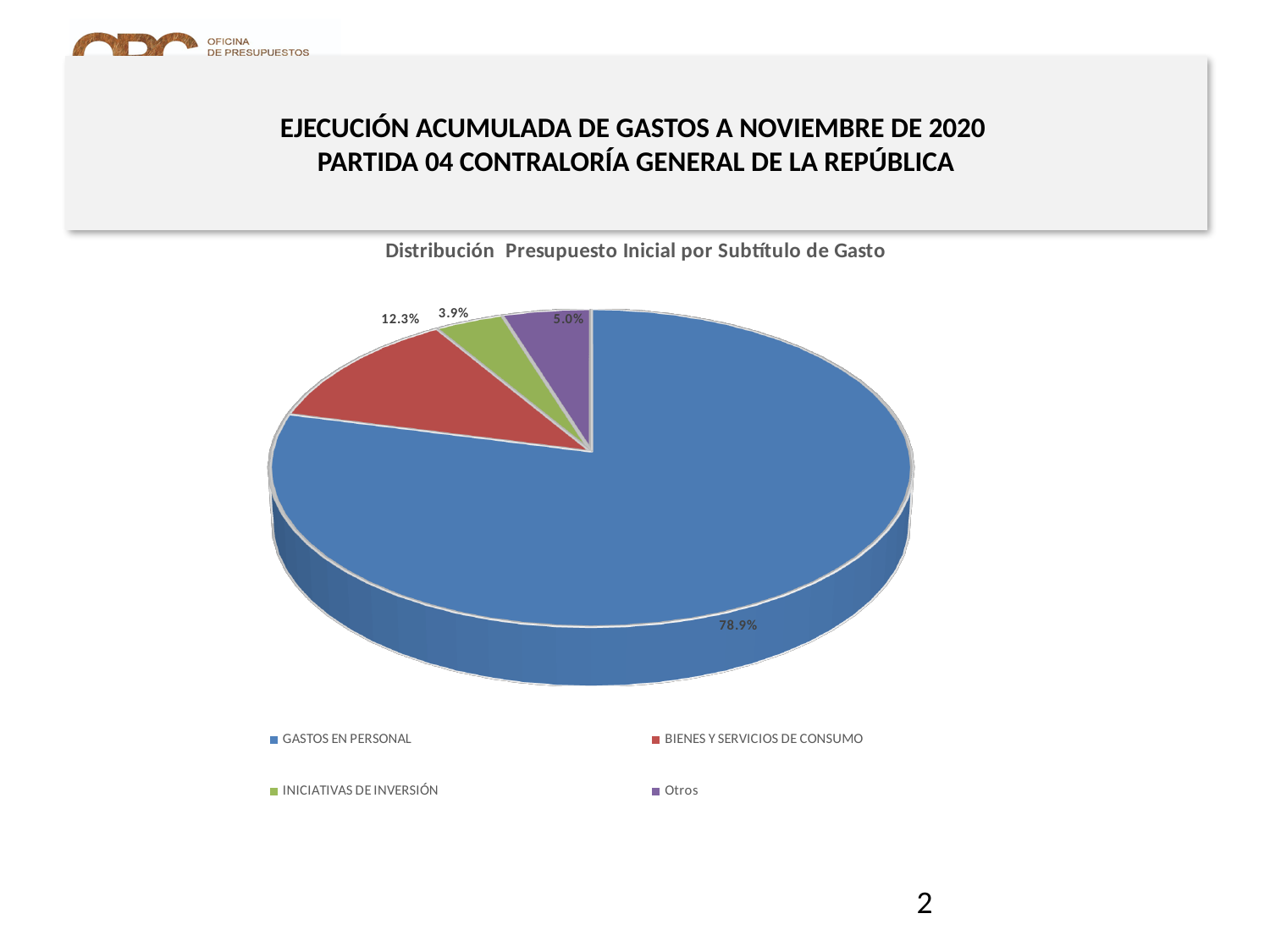
What share of the pie does INICIATIVAS DE INVERSIÓN represent? 3.9% Which category has the largest slice of the pie? GASTOS EN PERSONAL What share of the pie does GASTOS EN PERSONAL represent? 78.9% Which is larger, the share for Otros or the share for INICIATIVAS DE INVERSIÓN? Otros What is the title of the chart? Distribución Presupuesto Inicial por Subtítulo de Gasto What is the difference in percentage points between GASTOS EN PERSONAL and BIENES Y SERVICIOS DE CONSUMO? 66.6 What kind of chart is shown on the slide? Pie chart Which category has the smallest slice of the pie? INICIATIVAS DE INVERSIÓN What share of the pie does Otros represent? 5.0% How many categories does the pie chart show? 4 What colour is the slice for BIENES Y SERVICIOS DE CONSUMO? Red